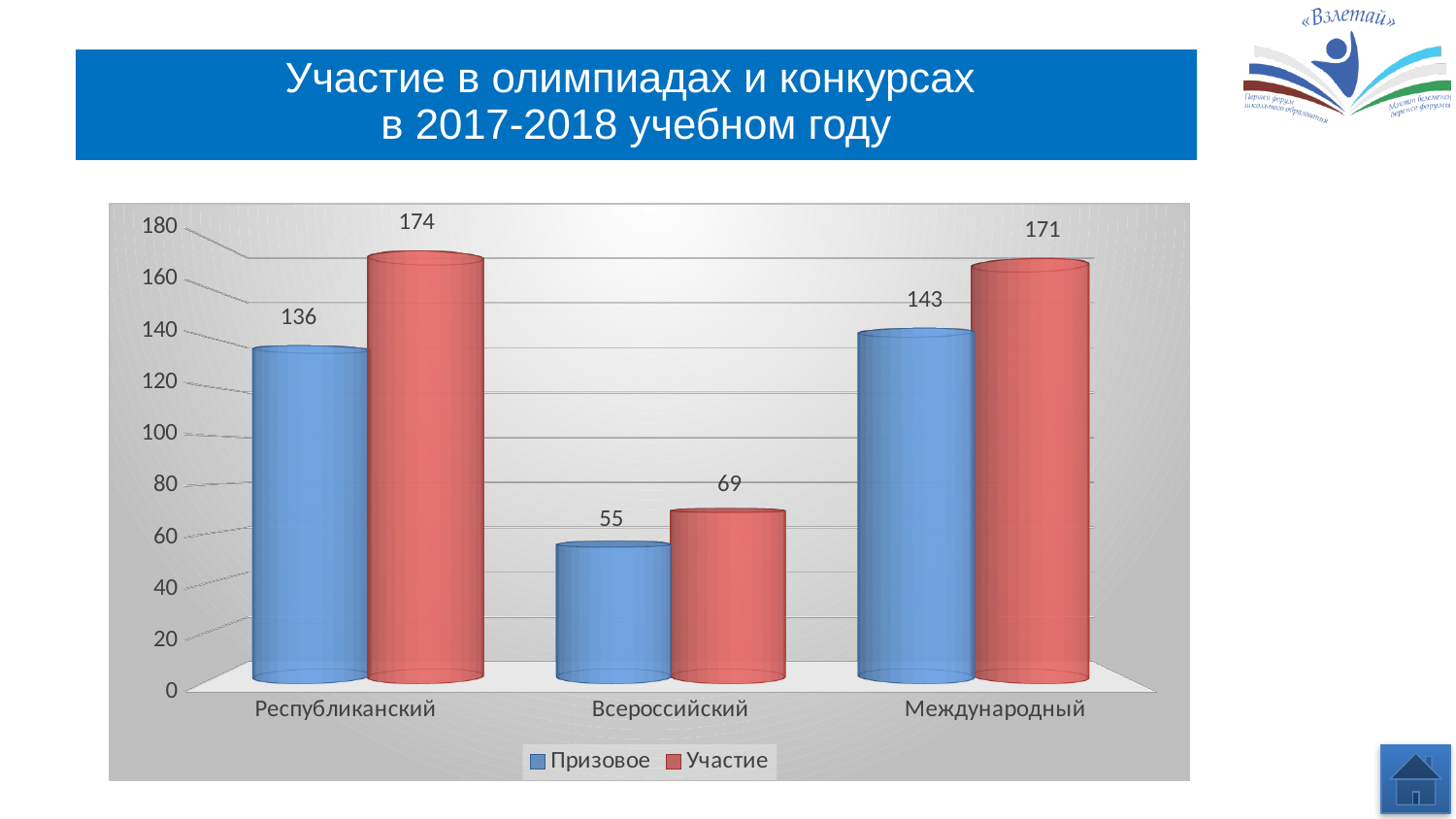
How many categories are shown on the x axis? 3 What kind of chart is shown on the slide? Bar chart Which series is shown in red? Участие What is the value of Призовое for Республиканский? 136 What is the value of Призовое for Международный? 143 Which is larger: Призовое for Международный or Призовое for Республиканский? Международный How many series does the legend list? 2 Which category has the highest Участие value? Республиканский What is the value of Участие for Всероссийский? 69 What is the difference between Участие and Призовое for Международный? 28 Which category has the lowest Призовое value? Всероссийский What is the difference between Участие and Призовое for Республиканский? 38